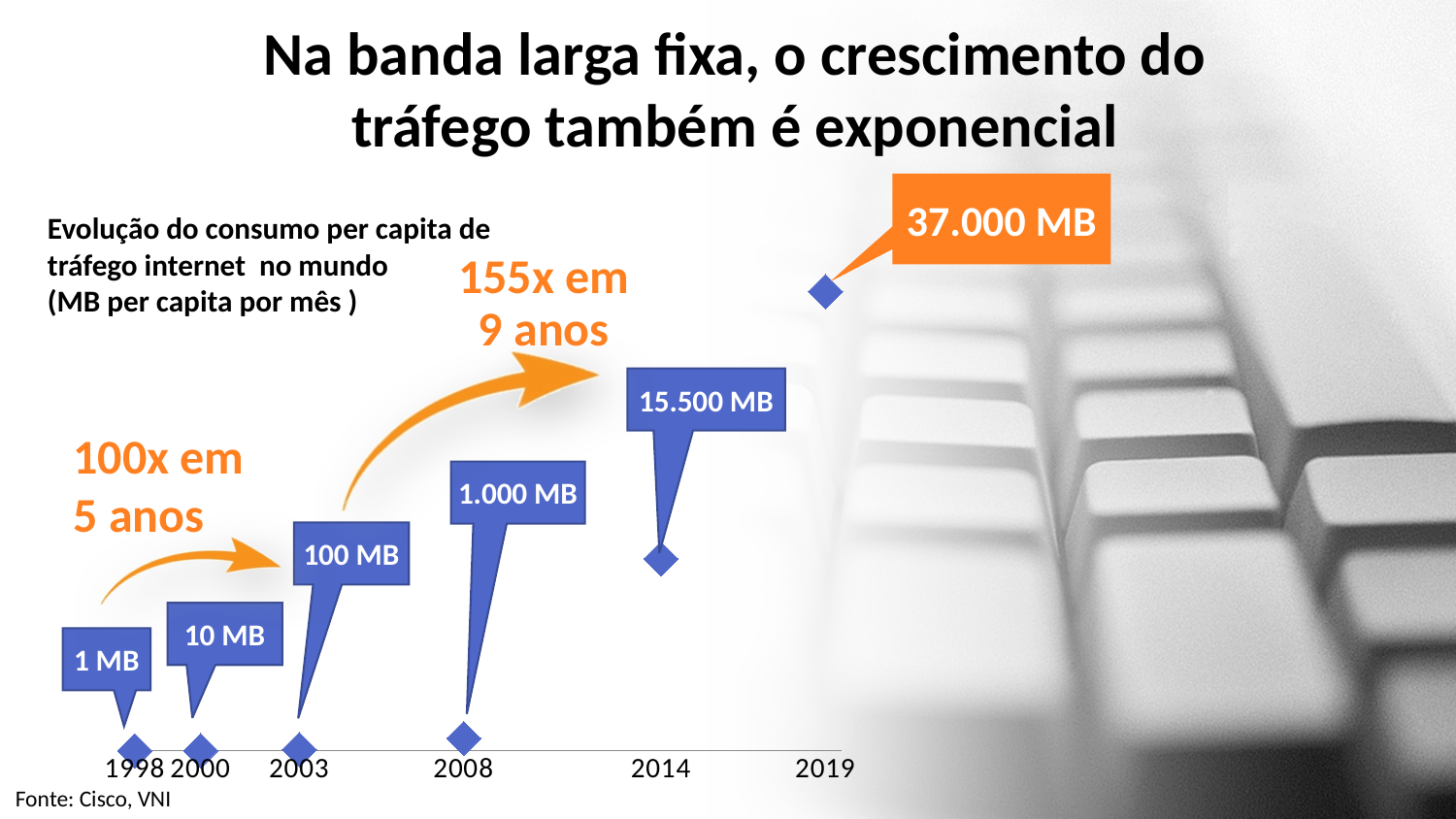
Which year has the highest value on the chart? 2019 What is the value plotted for 1998? 1 MB Which year has the lowest value on the chart? 1998 What is the value plotted for 2014? 15.500 MB Which is larger, the value for 2008 or the value for 2000? 2008 What is the difference between the values for 2019 and 2014? 21.500 MB What is the value plotted for 2019? 37.000 MB Do the values rise or fall from 1998 to 2019? rise How many data points are plotted on the chart? 6 What is the difference between the values for 2008 and 2003? 900 MB What is the value plotted for 2003? 100 MB What is the source cited for the chart? Cisco, VNI